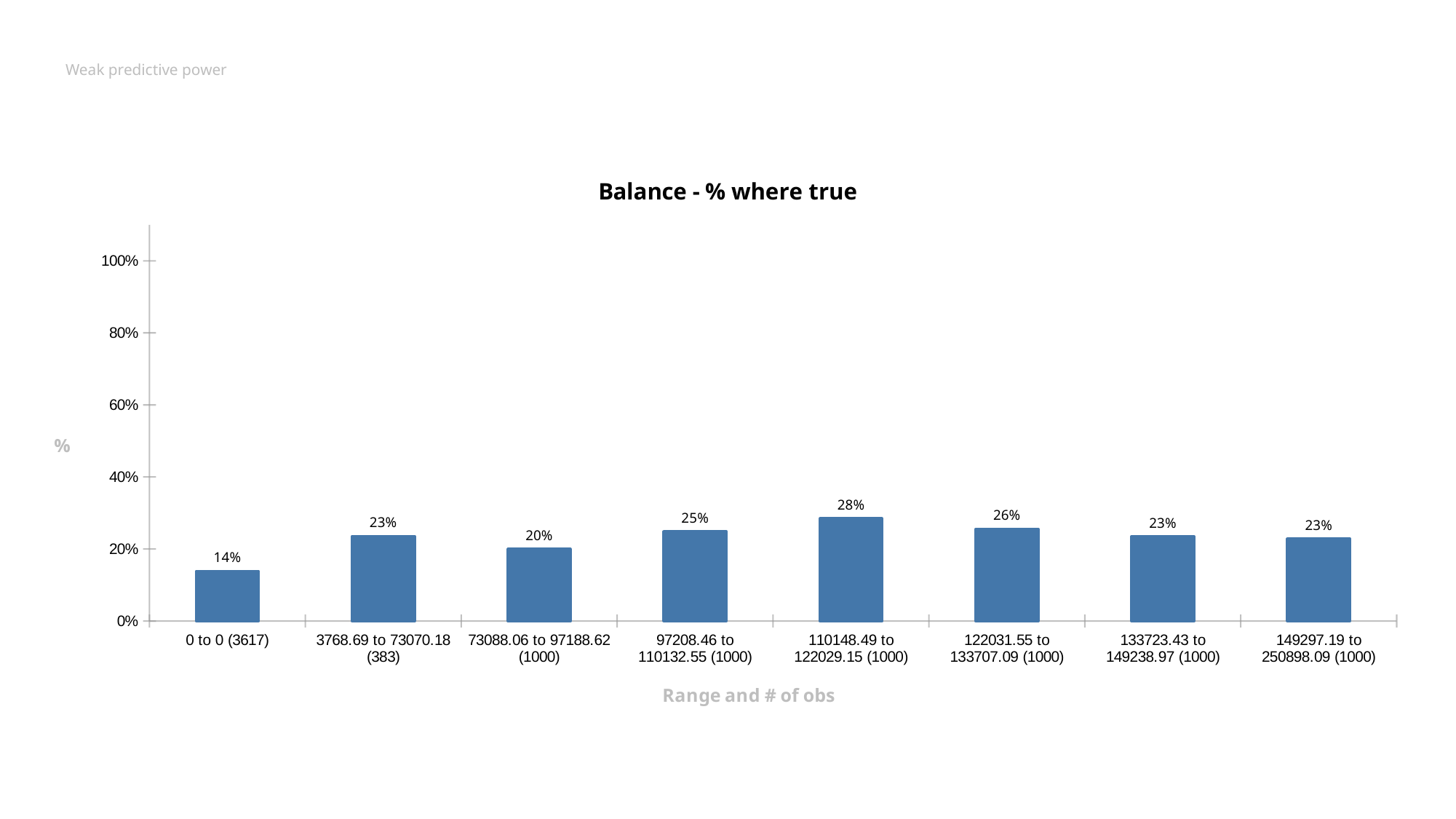
What kind of chart is shown on the slide? bar chart What is the value for the '73088.06 to 97188.62 (1000)' category? 20% Which category has the lowest value? 0 to 0 (3617) Which is larger, the value for '97208.46 to 110132.55 (1000)' or the value for '73088.06 to 97188.62 (1000)'? 97208.46 to 110132.55 (1000) What is the x-axis title of the chart? Range and # of obs What is the value for the '0 to 0 (3617)' category? 14% What is the difference between the values for '110148.49 to 122029.15 (1000)' and '0 to 0 (3617)'? 14% How many categories are shown on the x axis? 8 Which category has the highest value? 110148.49 to 122029.15 (1000) What is the title of the chart? Balance - % where true What is the value for the '110148.49 to 122029.15 (1000)' category? 28% Is the value for '122031.55 to 133707.09 (1000)' greater or less than 40%? less